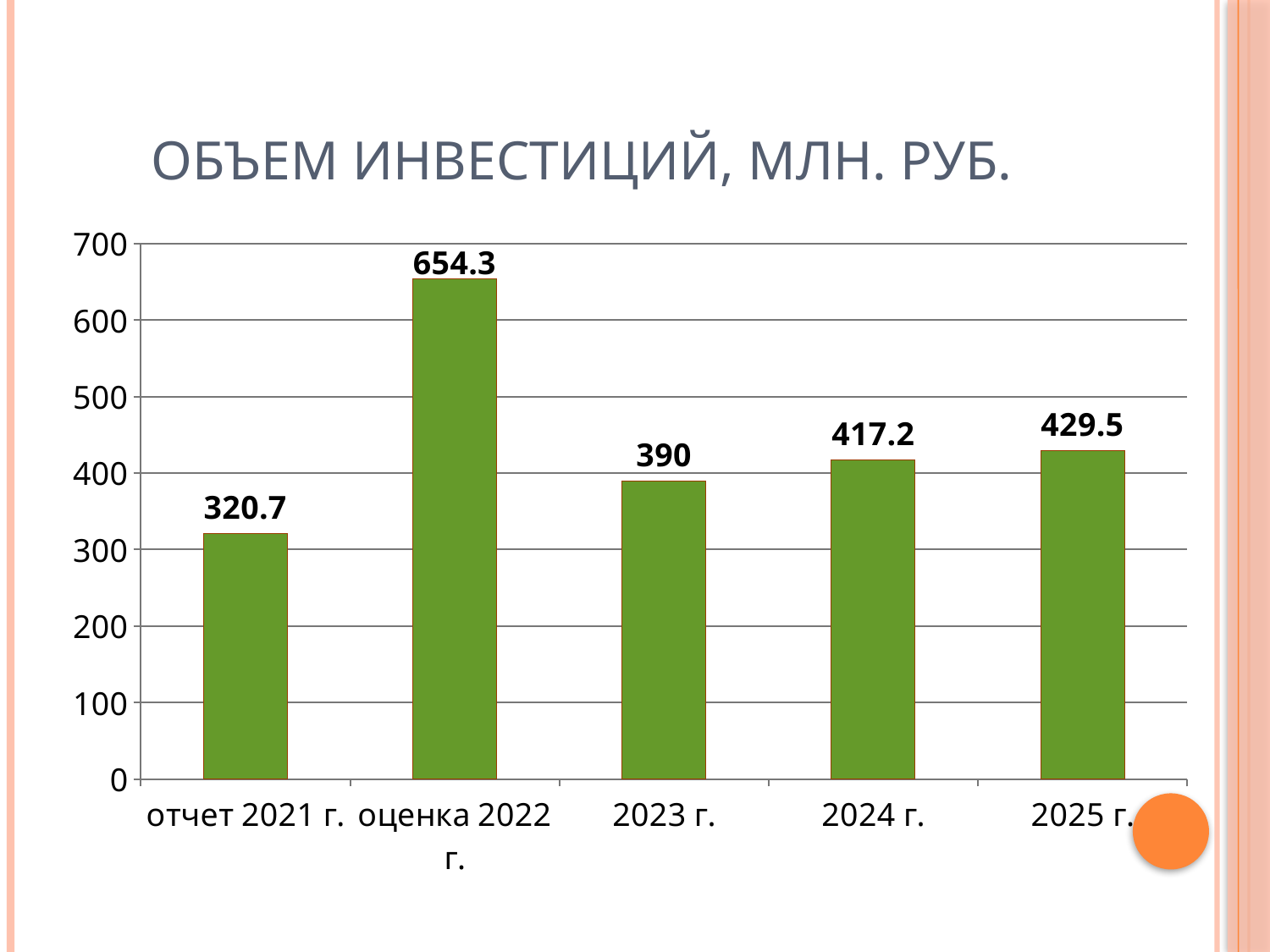
What kind of chart is shown on the slide? bar chart How many categories are shown on the x axis? 5 What is the value for отчет 2021 г.? 320.7 Which category has the lowest value? отчет 2021 г. What is the value for 2023 г.? 390 What is the difference between the values for оценка 2022 г. and 2023 г.? 264.3 Is the value for 2024 г. greater or less than 400? greater What is the value for оценка 2022 г.? 654.3 Which is larger, the value for 2024 г. or the value for 2025 г.? 2025 г. What is the value for 2025 г.? 429.5 Which category has the highest value? оценка 2022 г. What is the title of the chart? ОБЪЕМ ИНВЕСТИЦИЙ, МЛН. РУБ.